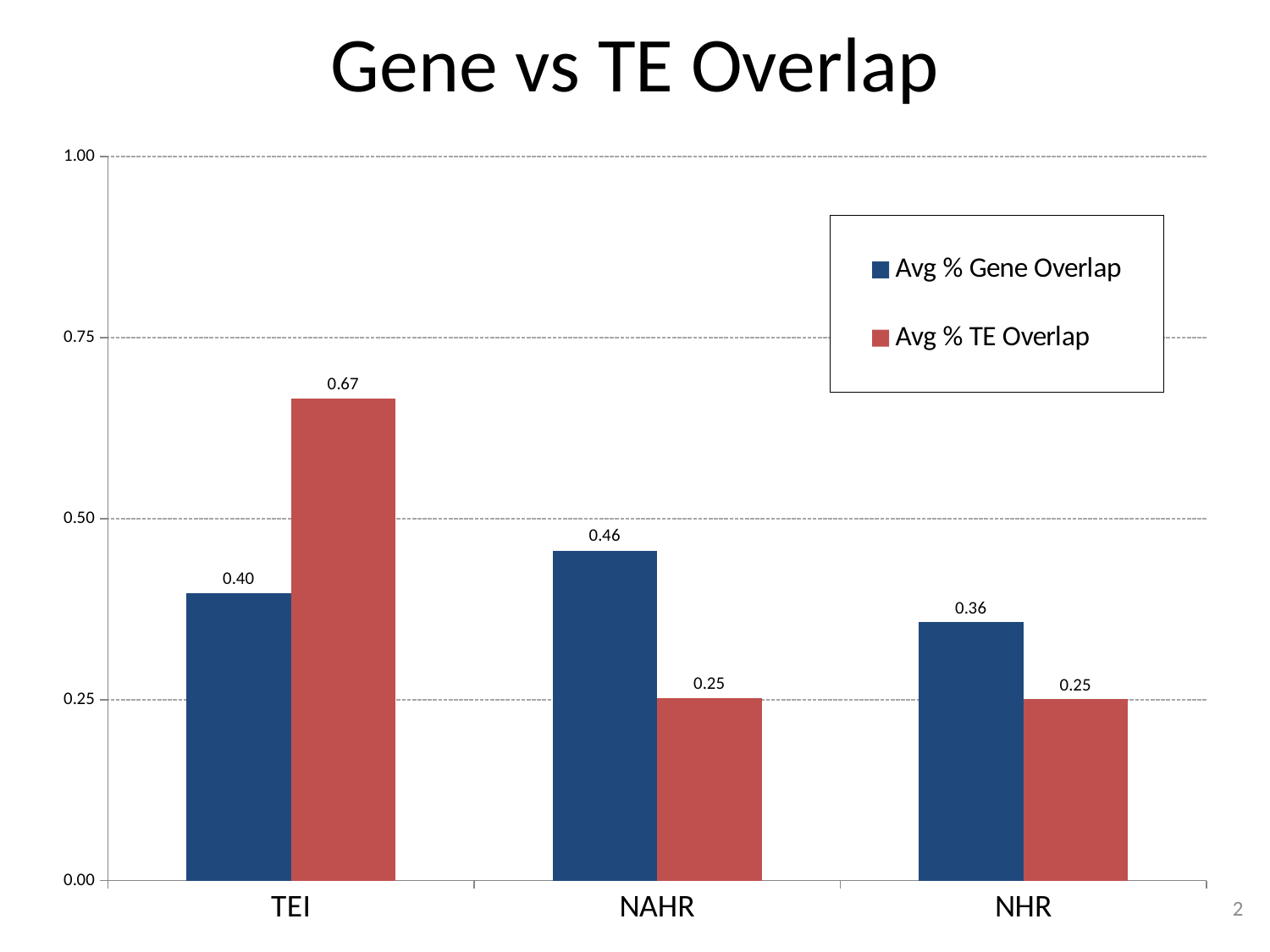
How many categories are shown on the x axis? 3 For NAHR, which is larger: Avg % Gene Overlap or Avg % TE Overlap? Avg % Gene Overlap What is the difference between the Avg % TE Overlap and Avg % Gene Overlap for TEI? 0.27 What is the Avg % Gene Overlap value for TEI? 0.40 What kind of chart is shown on the slide? Bar chart What is the title of the chart? Gene vs TE Overlap What is the Avg % TE Overlap value for TEI? 0.67 How many series does the legend list? 2 What is the Avg % Gene Overlap value for NAHR? 0.46 What is the Avg % TE Overlap value for NHR? 0.25 Which category has the lowest Avg % Gene Overlap? NHR Which category has the highest Avg % Gene Overlap? NAHR